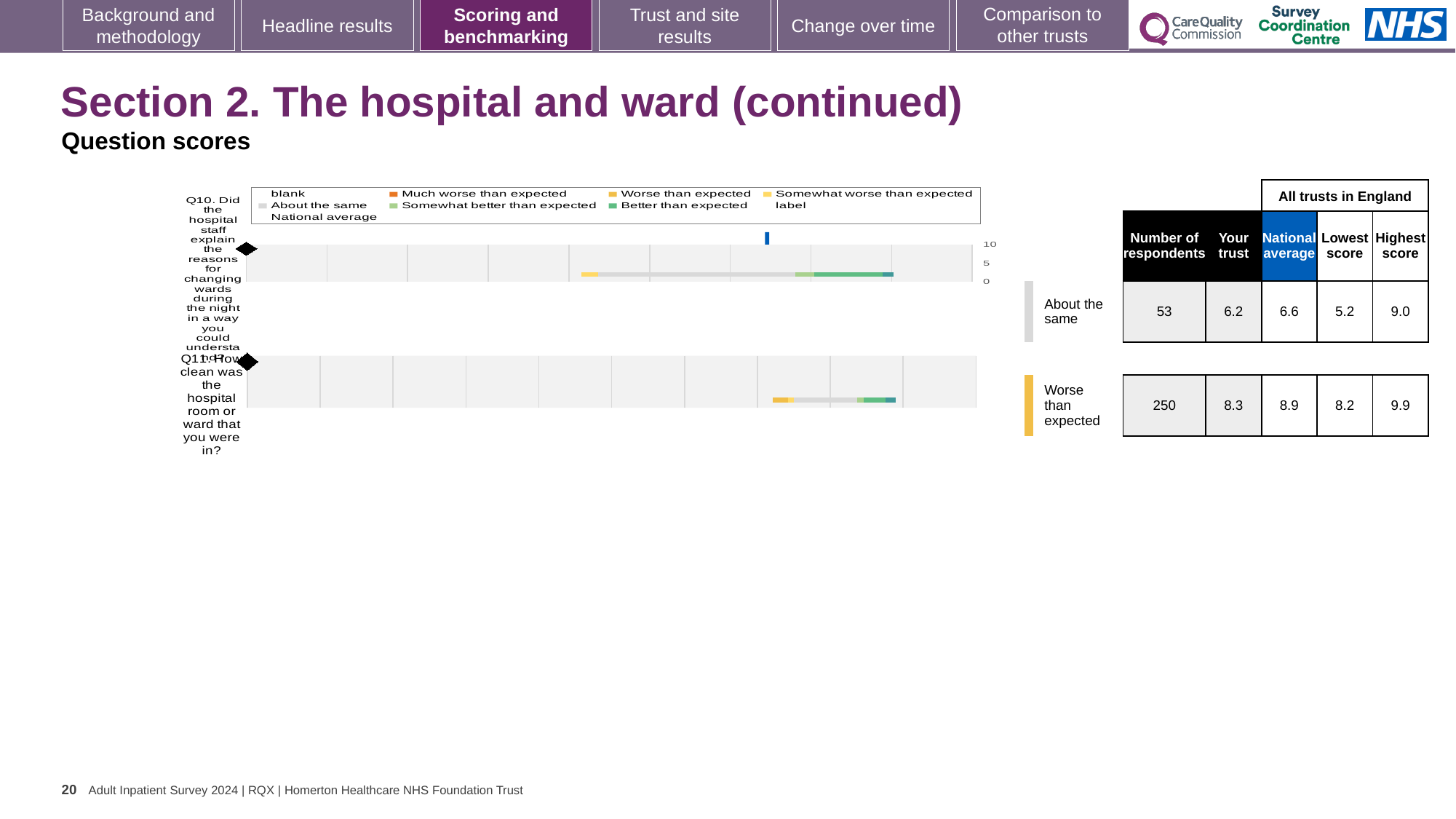
What is the national average score for Q11 (how clean was the hospital room or ward)? 8.9 What benchmark category is the trust's Q11 score placed in? Worse than expected How many respondents answered Q11? 250 What kind of chart is used to show the question scores for Q10 and Q11? bar chart What is the lowest score among all trusts in England for Q11? 8.2 What is the difference between the national average and the trust's score for Q11? 0.6 What is the difference between the highest and lowest scores in England for Q10? 3.8 Which question has the higher 'Your trust' score, Q10 or Q11? Q11 Which question has more respondents, Q10 or Q11? Q11 What is the highest score among all trusts in England for Q10? 9.0 How many questions (categories) are shown in the charts on this slide? 2 What is the 'Your trust' score for Q10 (explaining reasons for changing wards during the night)? 6.2